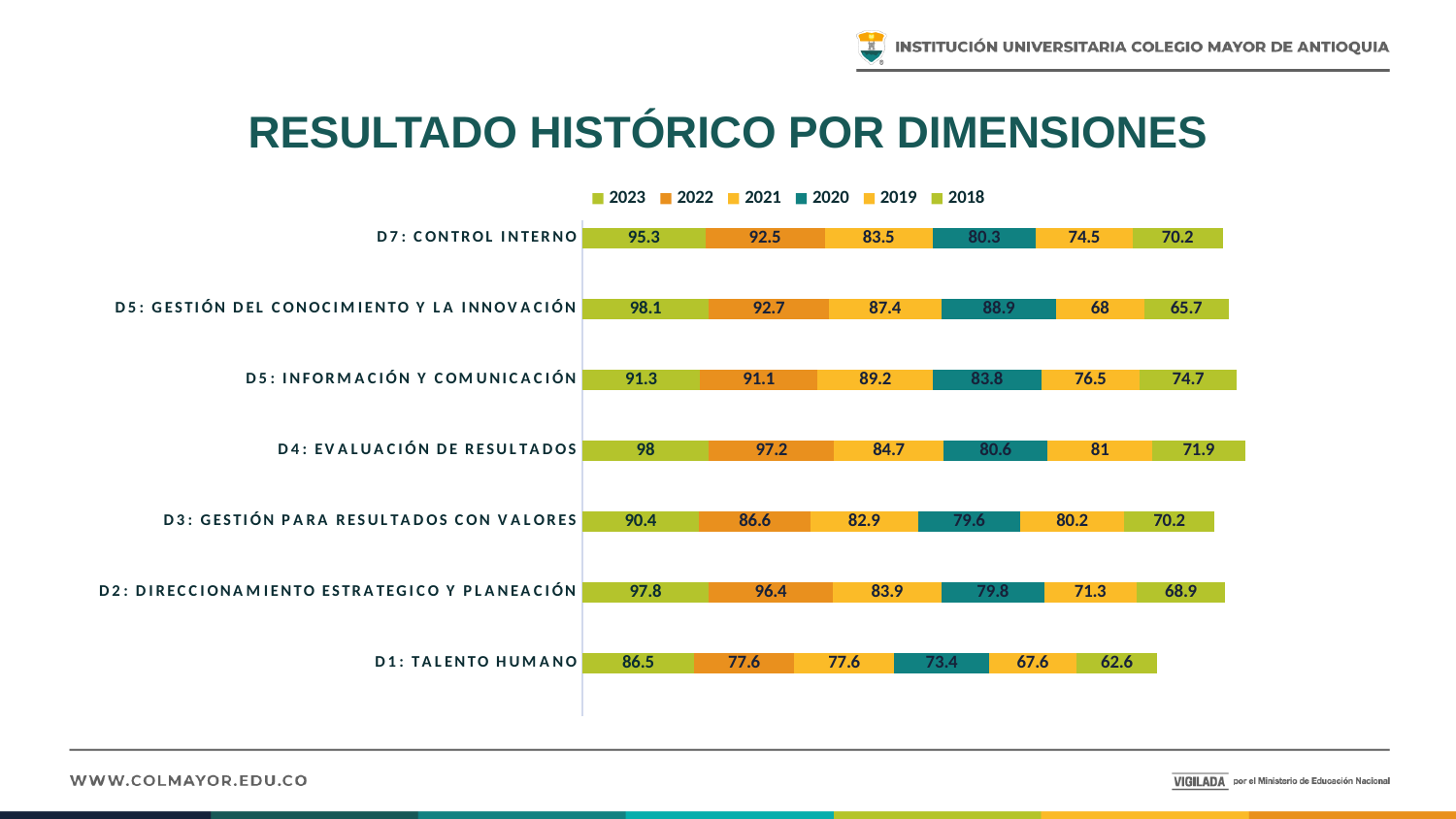
How many series does the legend list? 6 What is the 2023 value for D1: Talento Humano? 86.5 What is the difference between the 2023 and 2018 values for D1: Talento Humano? 23.9 Which dimension has the lowest 2023 value? D1: Talento Humano How many dimensions (categories) are plotted in the chart? 7 What is the 2018 value for D7: Control Interno? 70.2 Which dimension has the highest 2018 value? D5: Información y Comunicación What kind of chart is shown on the slide? bar chart From 2018 to 2023, do the values for D7: Control Interno rise or fall? rise What is the total of the stacked bar for D1: Talento Humano? 445.3 For D4: Evaluación de Resultados, which is larger, the 2020 value or the 2019 value? 2019 What is the 2022 value for D2: Direccionamiento Estratégico y Planeación? 96.4